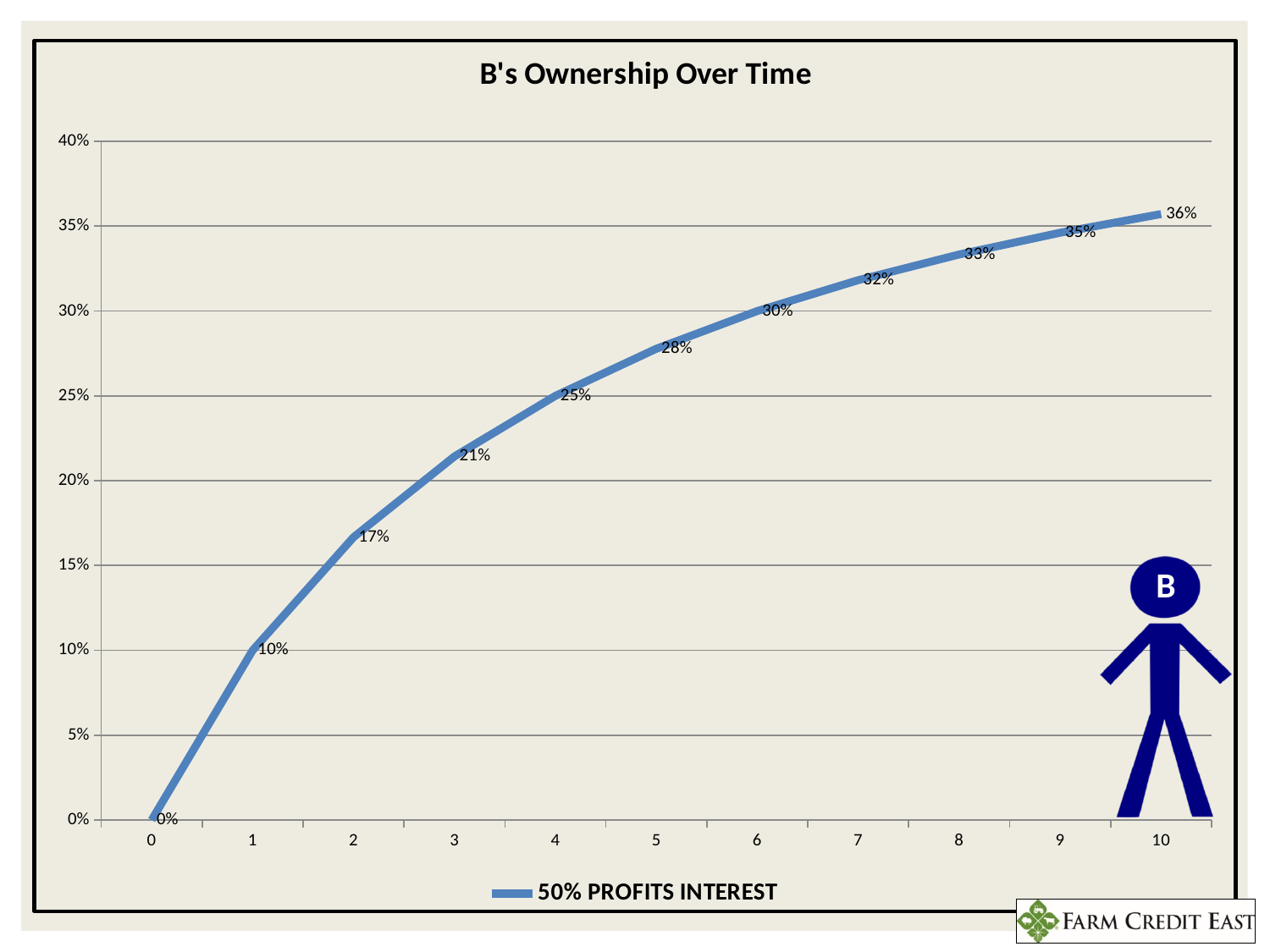
Does B's ownership rise or fall over time? rise At which year is B's ownership lowest? 0 What is B's ownership at year 10? 36% How many series does the legend list? 1 Which is larger, B's ownership at year 4 or at year 7? year 7 What is the difference between B's ownership at year 5 and at year 2? 11% What is B's ownership at year 1? 10% What kind of chart is shown? line chart At which year is B's ownership highest? 10 How many data points are plotted on the line? 11 What is B's ownership at year 3? 21% What is B's ownership at year 6? 30%